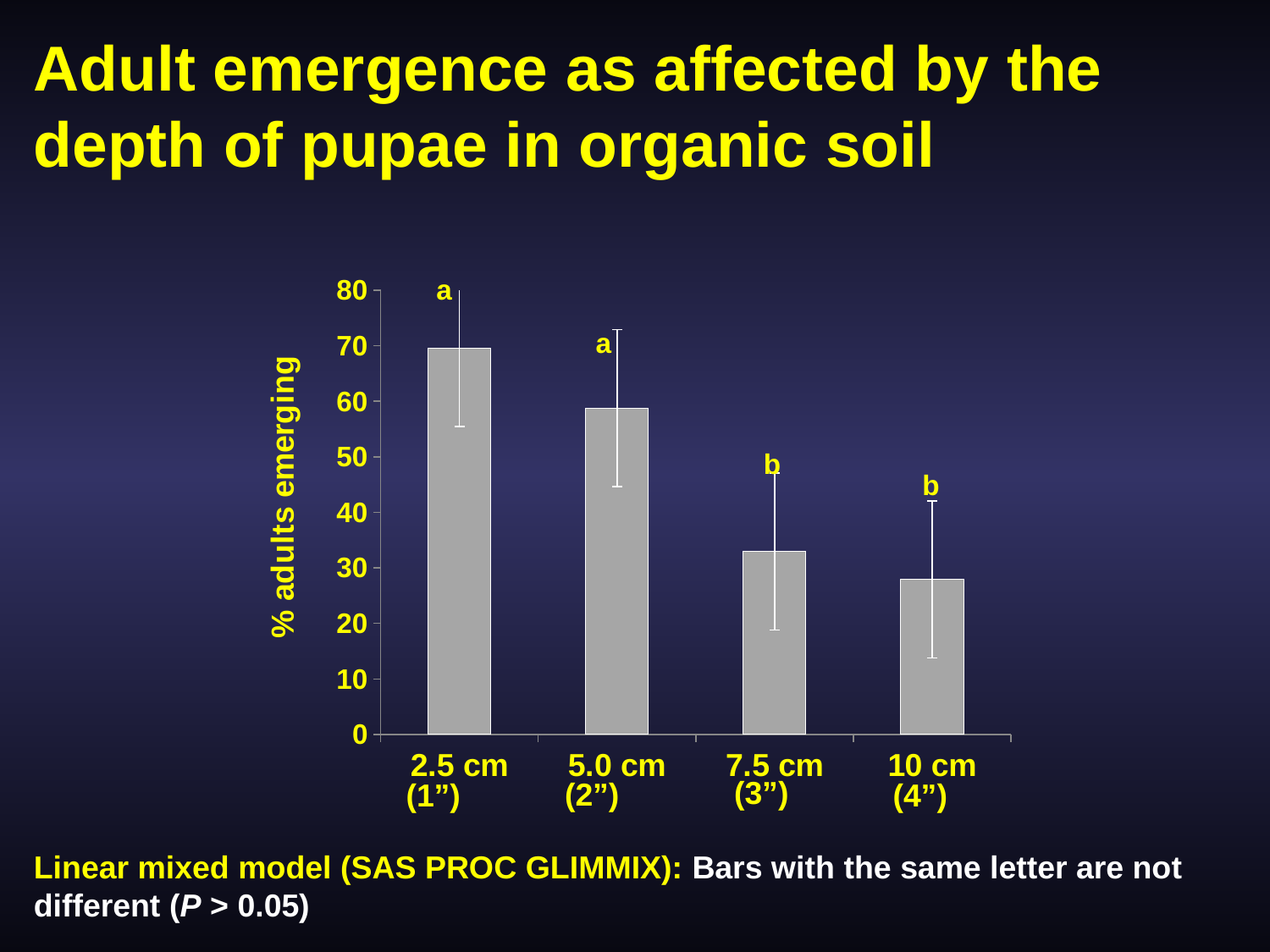
Which depth has the lowest % adults emerging? 10 cm (4") Which has a higher % adults emerging, 5.0 cm or 7.5 cm? 5.0 cm Is the value for 10 cm greater or less than 30? less Is the value for 2.5 cm greater or less than 60? greater Which depth has the highest % adults emerging? 2.5 cm (1") How many depth categories are plotted on the x axis? 4 What is the label on the y axis? % adults emerging Which letter is shown above the bars for 7.5 cm and 10 cm? b What kind of chart is shown on the slide? bar chart Is the value for 5.0 cm greater or less than 50? greater Do the values rise or fall as pupal depth increases along the x axis? fall